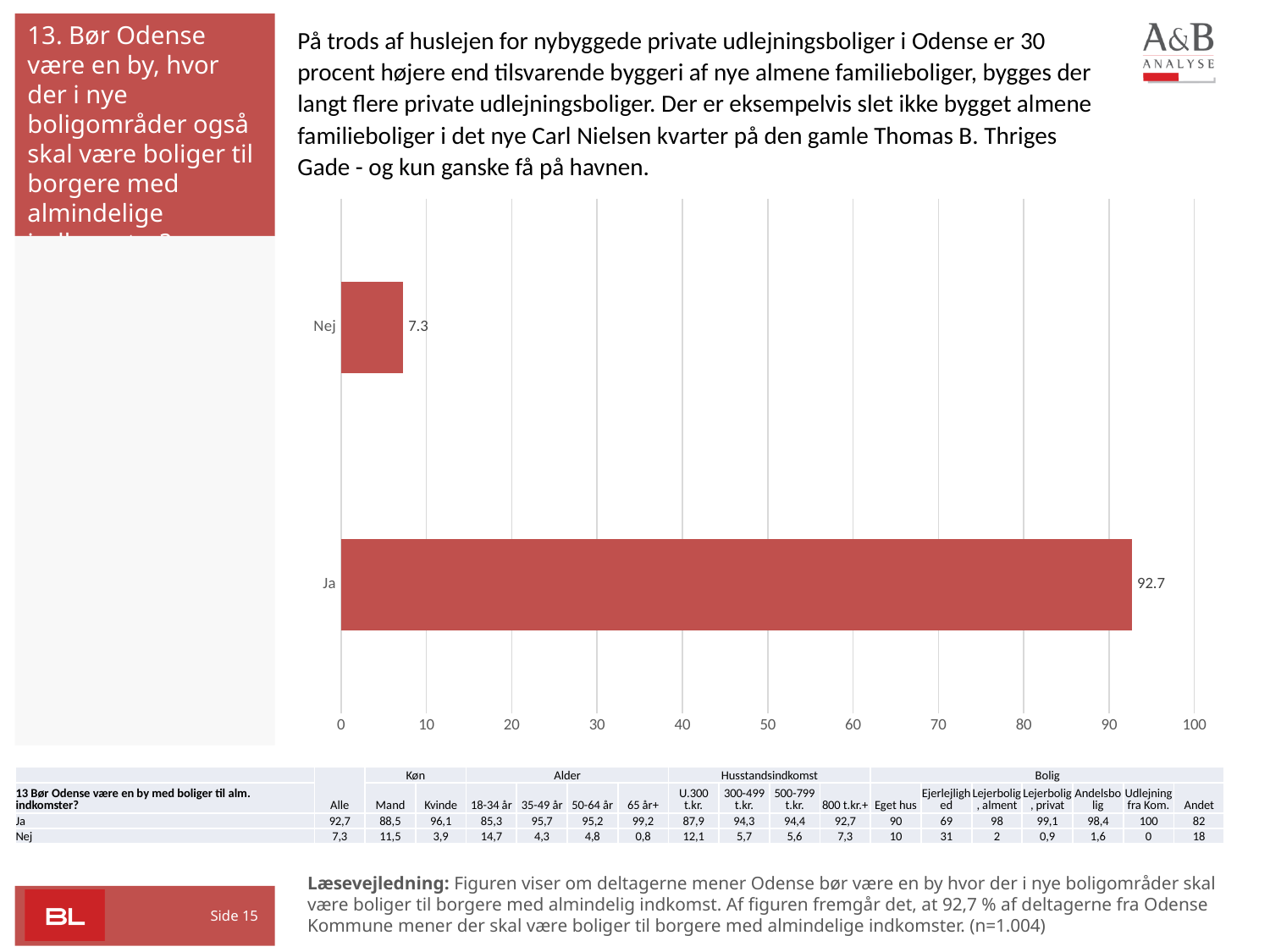
Which is larger in the bar chart, the value for "Ja" or the value for "Nej"? Ja What is the value for "Nej" in the bar chart? 7.3 How many categories are shown in the bar chart? 2 What kind of chart is shown on the slide? bar chart Which category has the highest value in the bar chart? Ja Is the value for "Ja" greater or less than 90? greater What is the value for "Ja" in the bar chart? 92.7 What is the maximum value shown on the horizontal axis of the bar chart? 100 Which category has the lowest value in the bar chart? Nej Is the value for "Nej" greater or less than 10? less What colour are the bars in the chart? red What is the difference between the values for "Ja" and "Nej" in the bar chart? 85.4